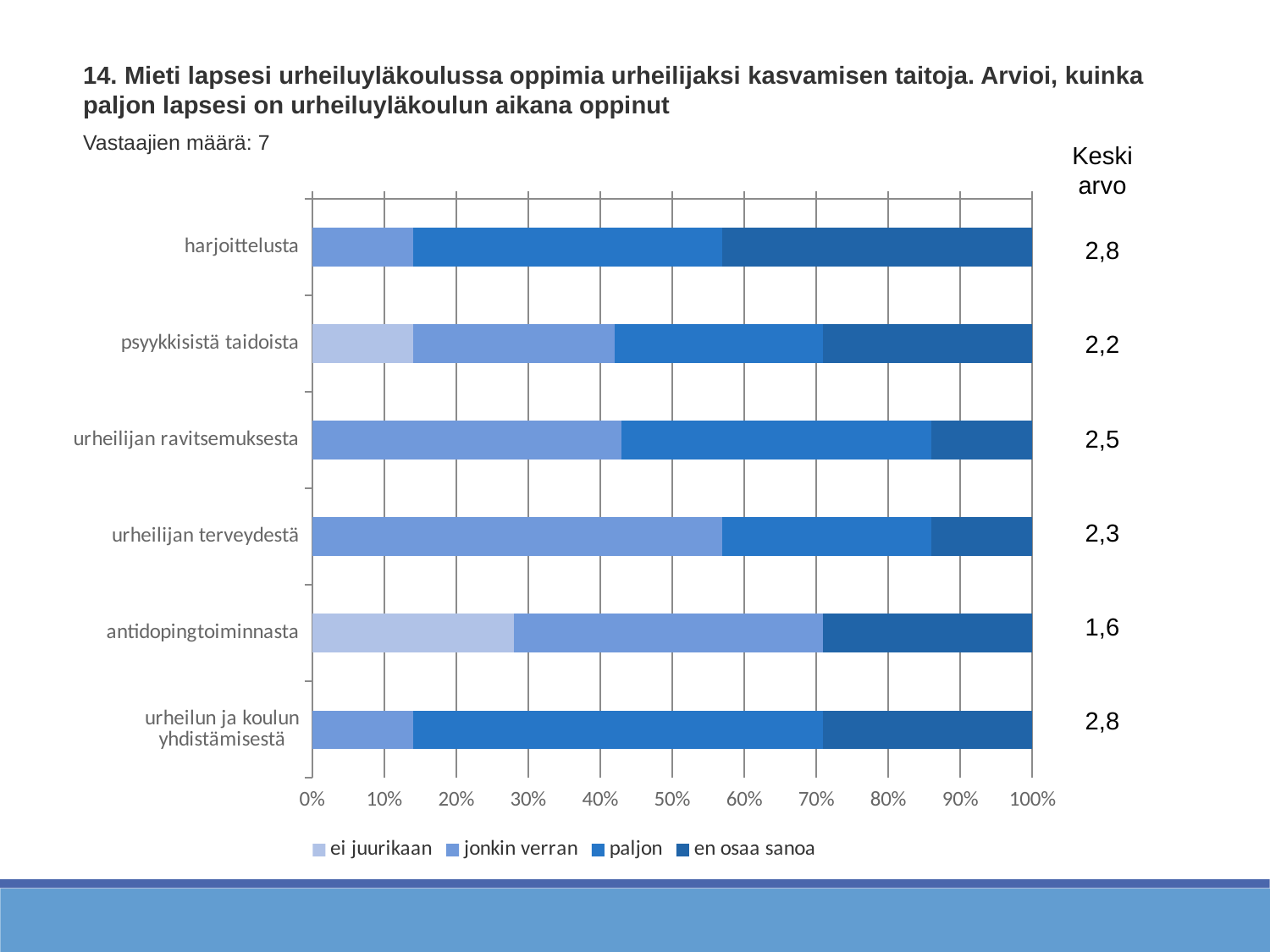
Which category has the larger 'paljon' share: harjoittelusta or psyykkisistä taidoista? harjoittelusta What is the Keskiarvo value shown for urheilijan ravitsemuksesta? 2,5 What is the Keskiarvo value shown for antidopingtoiminnasta? 1,6 What is the difference between the Keskiarvo values for harjoittelusta and antidopingtoiminnasta? 1,2 What kind of chart is shown on the slide? stacked bar chart Is the 'ei juurikaan' share for antidopingtoiminnasta greater or less than 20%? greater What is the first entry listed in the chart legend? ei juurikaan What is the Keskiarvo value shown for psyykkisistä taidoista? 2,2 How many categories are plotted on the chart? 6 How many series does the legend list? 4 Which category has the lowest Keskiarvo value? antidopingtoiminnasta Is the 'jonkin verran' share for urheilijan terveydestä greater or less than 50%? greater